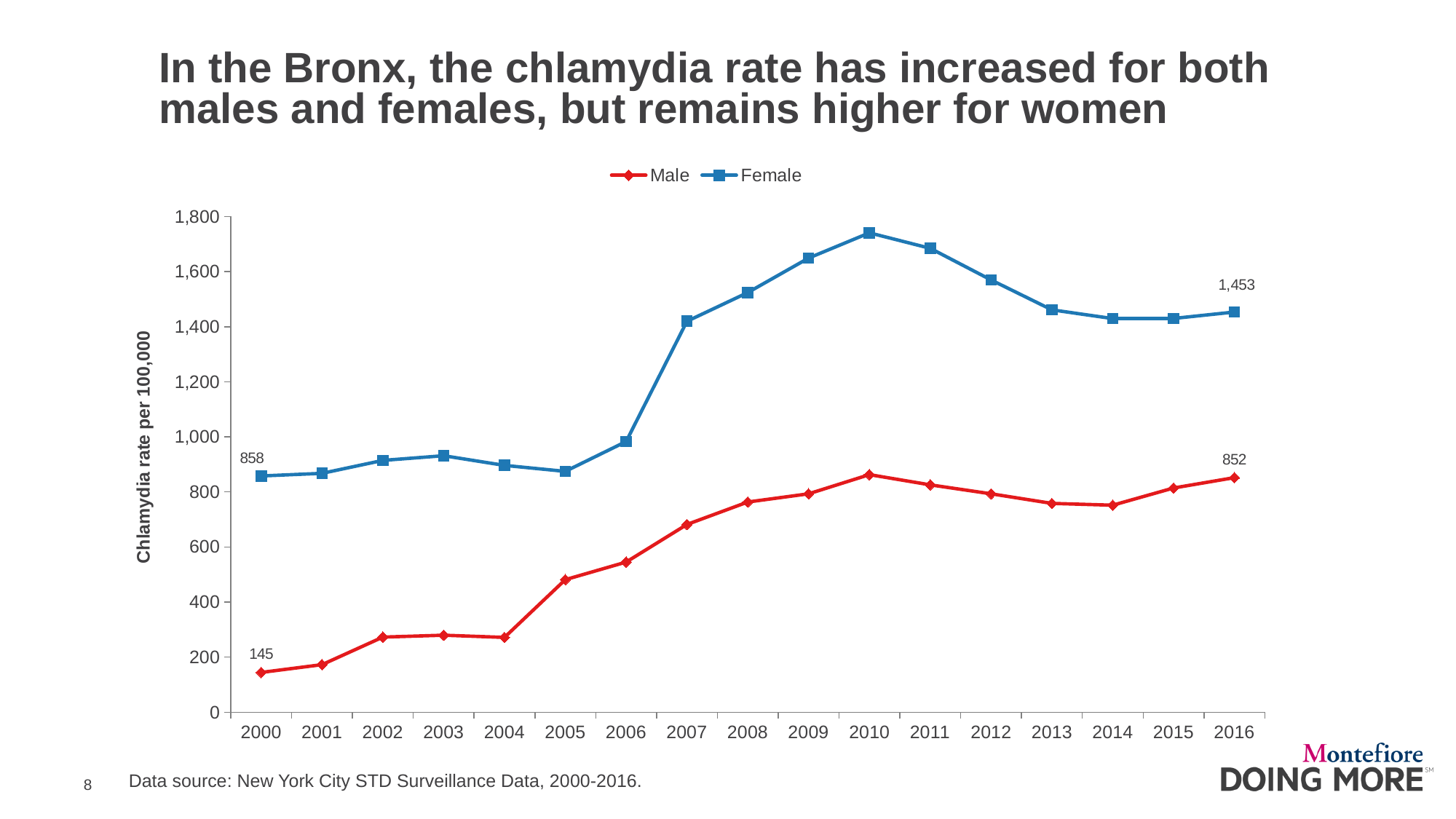
By how much did the Male chlamydia rate increase from 2000 to 2016? 707 What is the Female chlamydia rate in 2016? 1,453 How many series does the legend list? 2 Is the Female chlamydia rate in 2007 greater or less than 1,200? greater In which year is the Male series at its lowest value? 2000 What type of chart is shown on the slide? Line chart Which series has the higher value in 2010, Male or Female? Female What is the Male chlamydia rate in 2016? 852 What is the Male chlamydia rate in 2000? 145 In which year does the Female series reach its highest value? 2010 What is the Female chlamydia rate in 2000? 858 What is the difference between the Female and Male chlamydia rates in 2016? 601